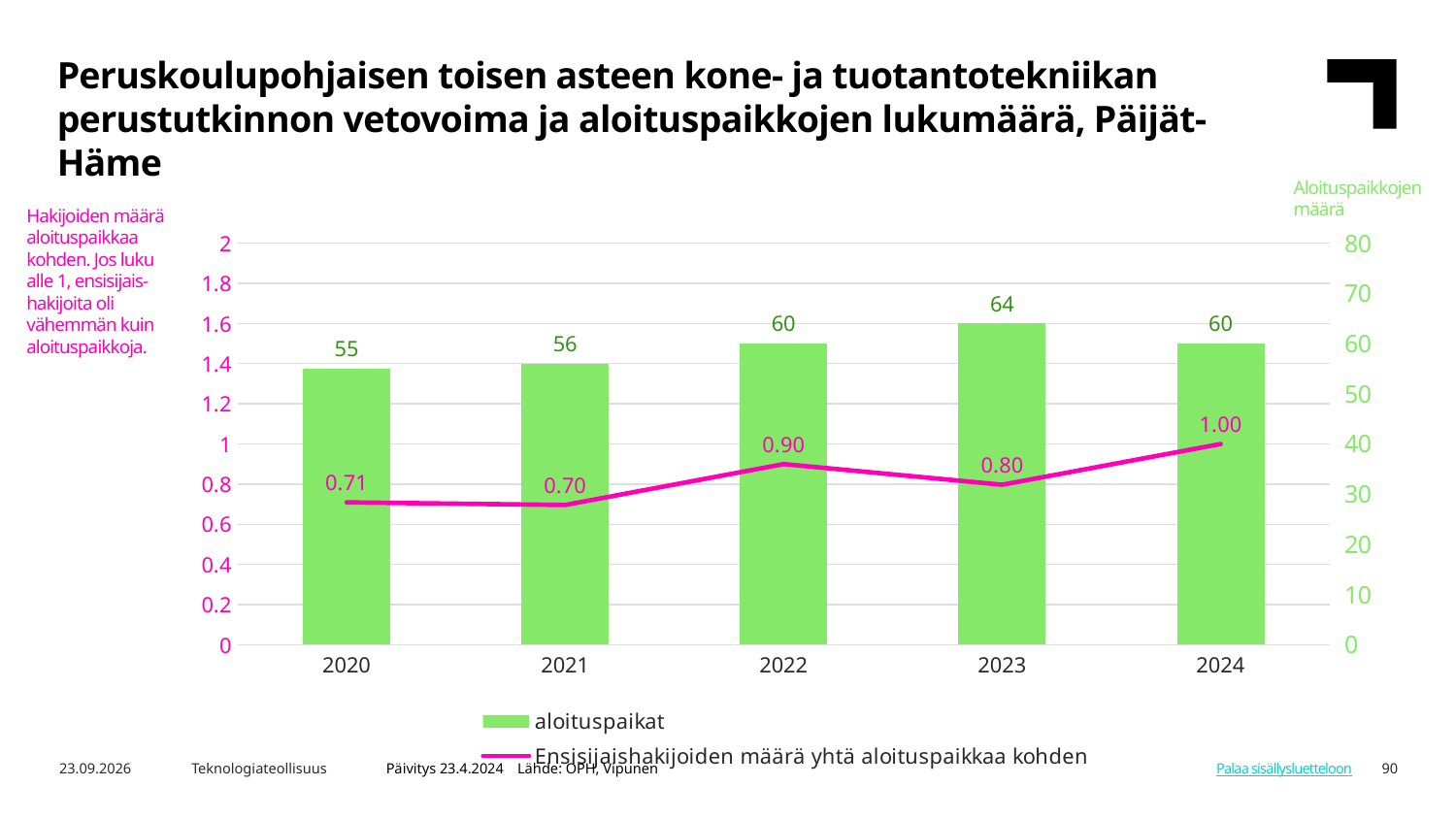
How many series does the legend list? 2 Which year has the lowest value for Ensisijaishakijoiden määrä yhtä aloituspaikkaa kohden? 2021 Which is larger, the Ensisijaishakijoiden määrä yhtä aloituspaikkaa kohden value for 2022 or for 2023? 2022 What is the difference between the aloituspaikat values for 2023 and 2020? 9 What colour are the aloituspaikat bars? green What kind of chart is used for the aloituspaikat series? bar chart Does the Ensisijaishakijoiden määrä yhtä aloituspaikkaa kohden line rise or fall from 2021 to 2024? rise Which year has the highest value for aloituspaikat? 2023 What is the value of aloituspaikat for 2023? 64 What is the value of Ensisijaishakijoiden määrä yhtä aloituspaikkaa kohden for 2024? 1.00 How many years are shown on the x axis? 5 What is the value of aloituspaikat for 2020? 55